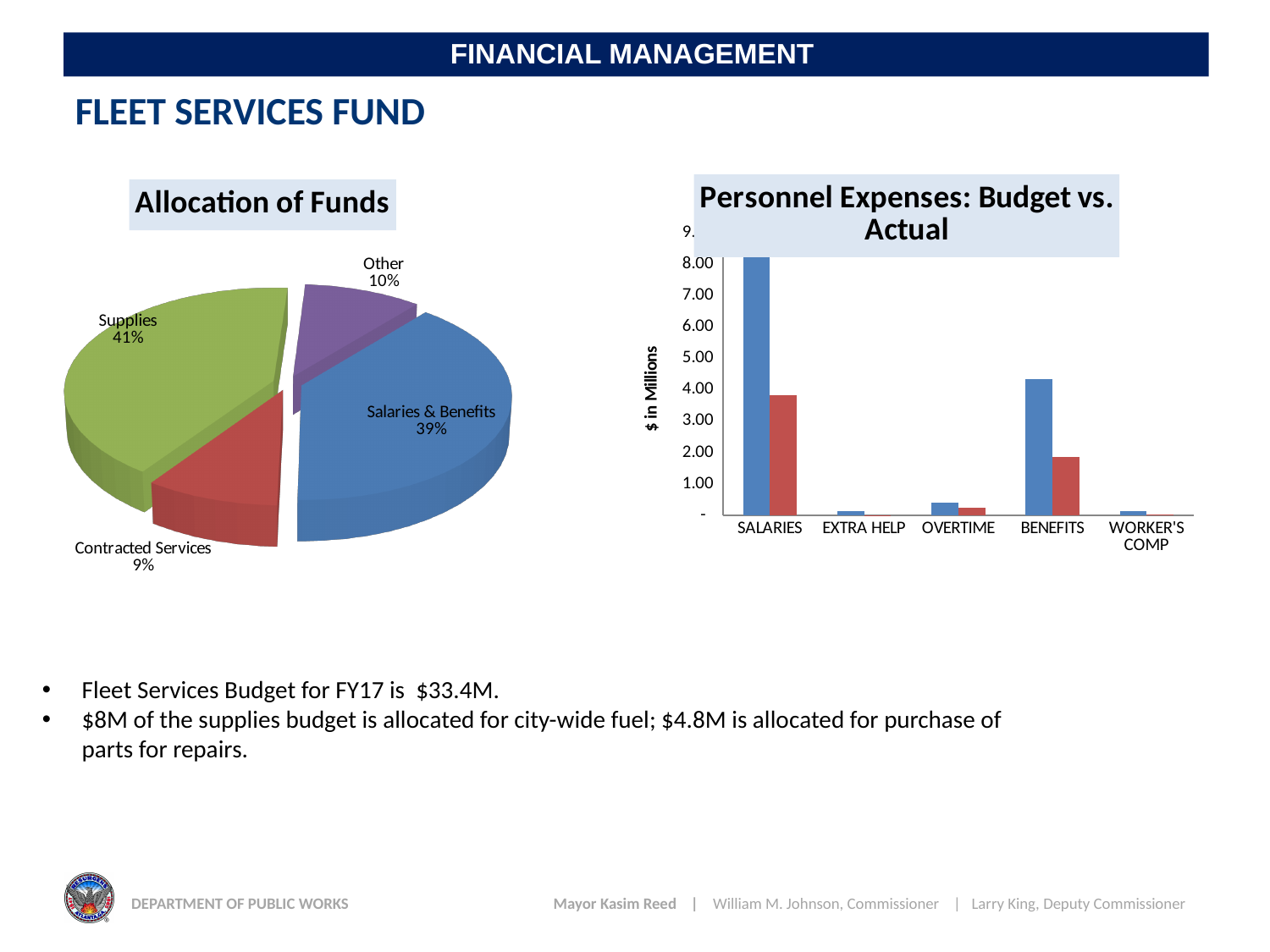
In the Allocation of Funds chart, how many percentage points larger is Supplies than Other? 31 What kind of chart is the Personnel Expenses: Budget vs. Actual chart? Bar chart In the Allocation of Funds chart, which category has the smallest share? Contracted Services What kind of chart is the Allocation of Funds chart? Pie chart How many expense categories are shown on the x axis of the Personnel Expenses: Budget vs. Actual chart? 5 In the Allocation of Funds chart, what share of funds goes to Supplies? 41% In the Allocation of Funds chart, which category has the largest share? Supplies In the Allocation of Funds chart, what percentage is Contracted Services? 9% In the Allocation of Funds chart, which is larger: Salaries & Benefits or Other? Salaries & Benefits In the Personnel Expenses: Budget vs. Actual chart, which category has the tallest blue bar? SALARIES How many slices does the Allocation of Funds pie chart have? 4 In the Personnel Expenses: Budget vs. Actual chart, is the blue bar for SALARIES greater or less than 7.00? greater